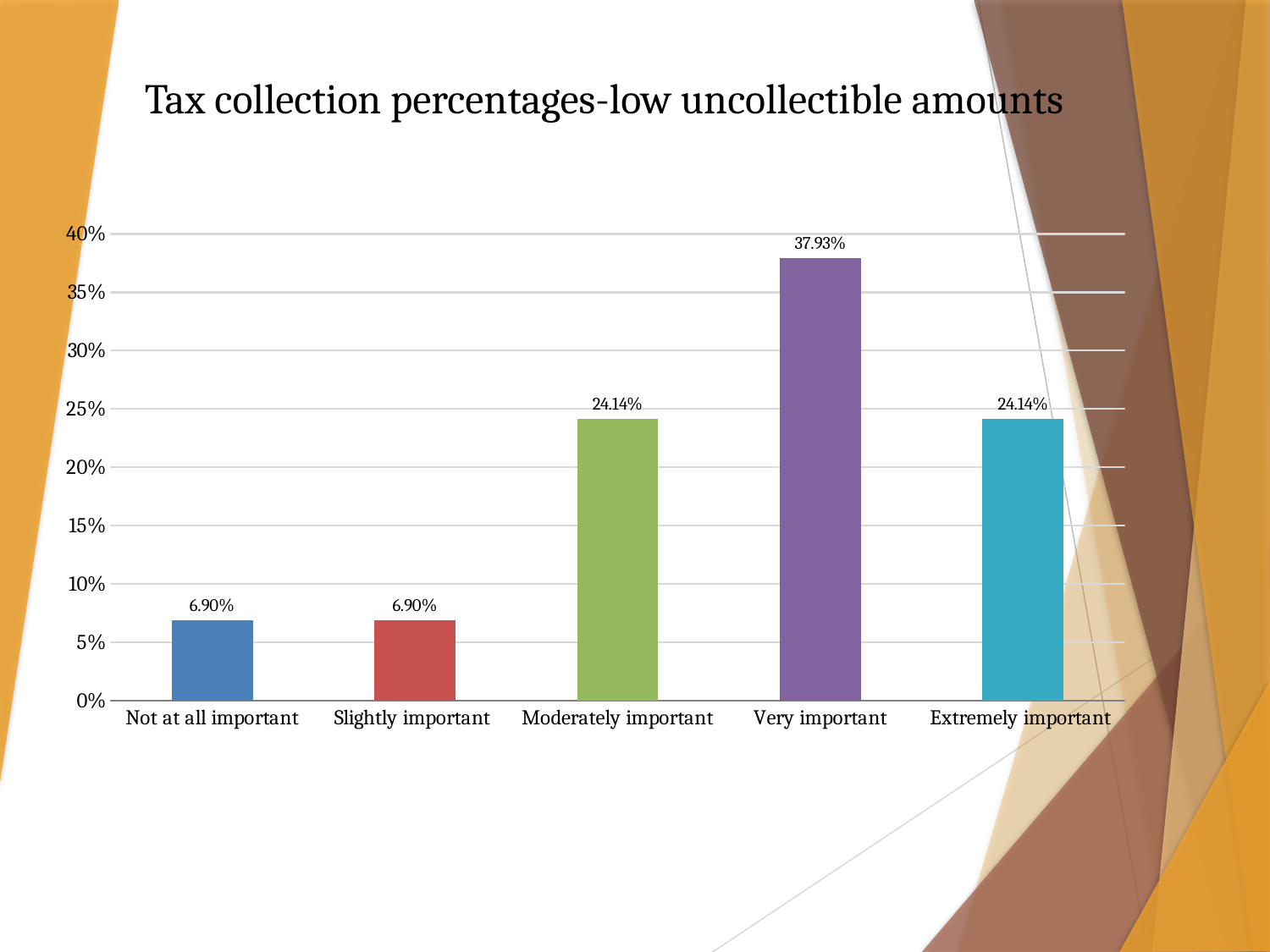
Which is larger, the value for Very important or the value for Moderately important? Very important What kind of chart is shown on the slide? bar chart What is the value for Very important? 37.93% What is the title of the chart? Tax collection percentages-low uncollectible amounts What is the difference between the values for Moderately important and Slightly important? 17.24% Is the value for Very important greater or less than 35%? greater How many categories are shown on the x axis? 5 What is the value for Not at all important? 6.90% What is the value for Moderately important? 24.14% What is the difference between the values for Very important and Extremely important? 13.79% What is the value for Extremely important? 24.14% Which category has the highest value? Very important